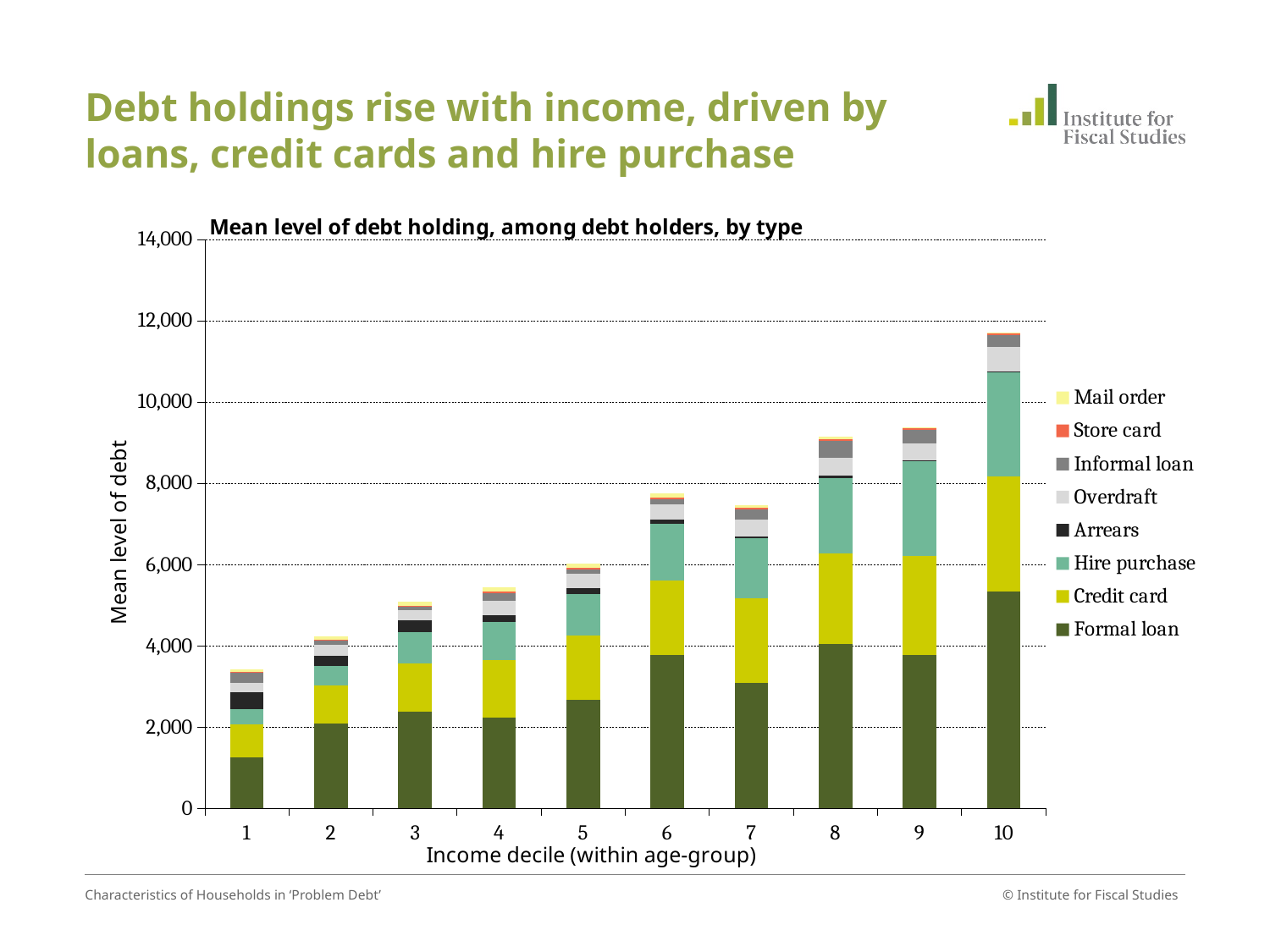
Does the total mean level of debt generally rise or fall as income decile increases? rise What kind of chart is shown on the slide? Stacked bar chart What is the title of the chart? Mean level of debt holding, among debt holders, by type How many income deciles are shown on the x axis? 10 Which income decile has the lowest total mean level of debt? 1 How many debt types does the legend list? 8 Is the total mean level of debt for income decile 1 greater or less than 4,000? less Is the total mean level of debt for income decile 8 greater or less than 8,000? greater Is the Formal loan value for income decile 10 greater or less than 4,000? greater Which debt type forms the bottom segment of each stacked bar? Formal loan Which income decile has the highest total mean level of debt? 10